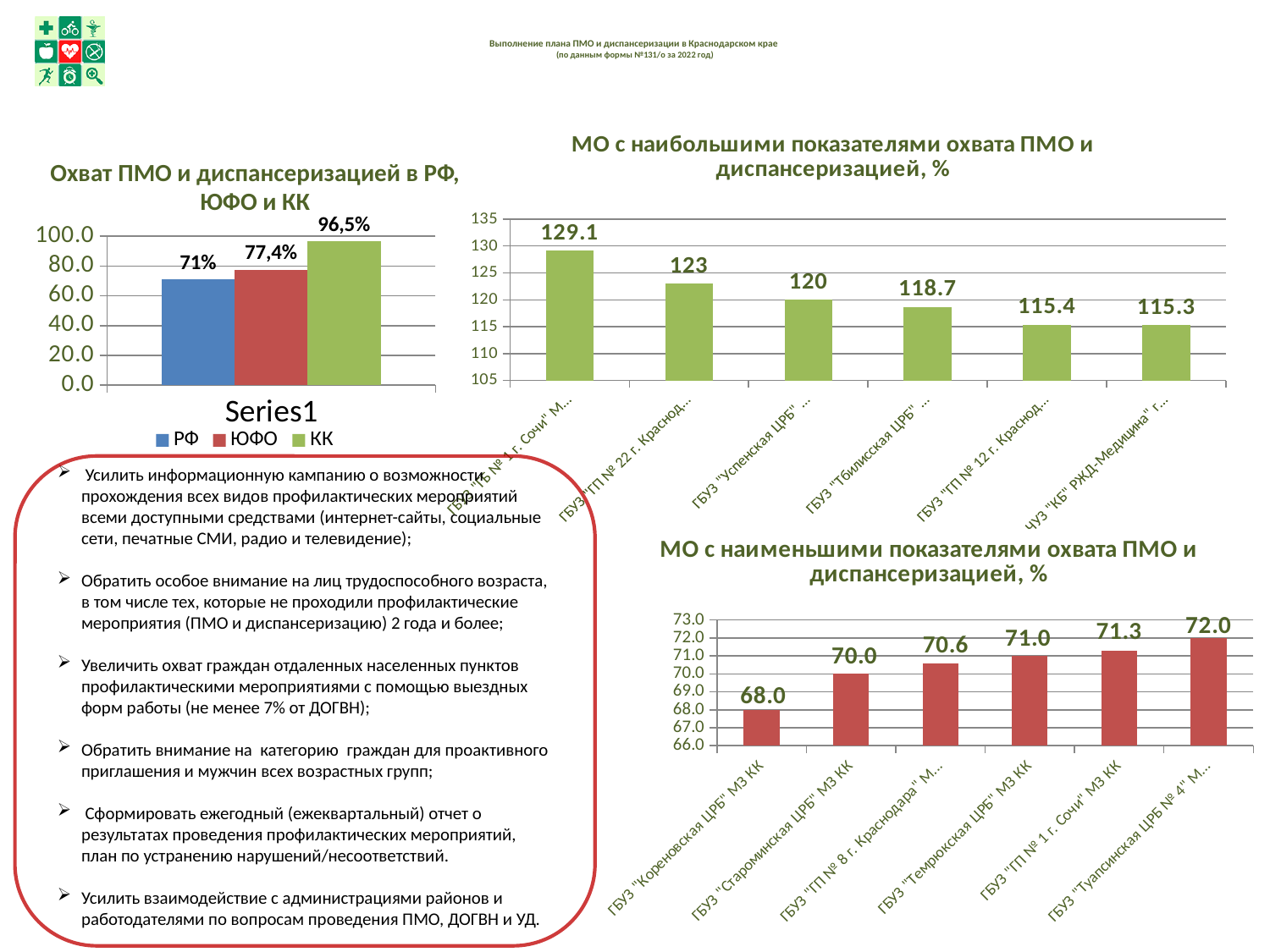
In the chart 'Охват ПМО и диспансеризацией в РФ, ЮФО и КК', which series has the lowest value? РФ In the chart 'МО с наименьшими показателями охвата ПМО и диспансеризацией, %', what is the difference between the values for ГБУЗ "Туапсинская ЦРБ № 4" and ГБУЗ "Кореновская ЦРБ" МЗ КК? 4.0 In the chart 'Охват ПМО и диспансеризацией в РФ, ЮФО и КК', what is the value for КК? 96,5% In the chart 'МО с наибольшими показателями охвата ПМО и диспансеризацией, %', what is the value for ГБУЗ "Тбилисская ЦРБ"? 118.7 In the chart 'МО с наибольшими показателями охвата ПМО и диспансеризацией, %', what is the highest value shown? 129.1 What kind of chart is 'МО с наименьшими показателями охвата ПМО и диспансеризацией, %'? Bar chart How many series does the legend of the chart 'Охват ПМО и диспансеризацией в РФ, ЮФО и КК' list? 3 In the chart 'Охват ПМО и диспансеризацией в РФ, ЮФО и КК', what is the value for РФ? 71% In the chart 'МО с наименьшими показателями охвата ПМО и диспансеризацией, %', what is the value for ГБУЗ "Темрюкская ЦРБ" МЗ КК? 71.0 In the chart 'МО с наименьшими показателями охвата ПМО и диспансеризацией, %', which organisation has the lowest value? ГБУЗ "Кореновская ЦРБ" МЗ КК How many bars are in the chart 'МО с наибольшими показателями охвата ПМО и диспансеризацией, %'? 6 In the chart 'МО с наибольшими показателями охвата ПМО и диспансеризацией, %', what is the value for ГБУЗ "Успенская ЦРБ"? 120